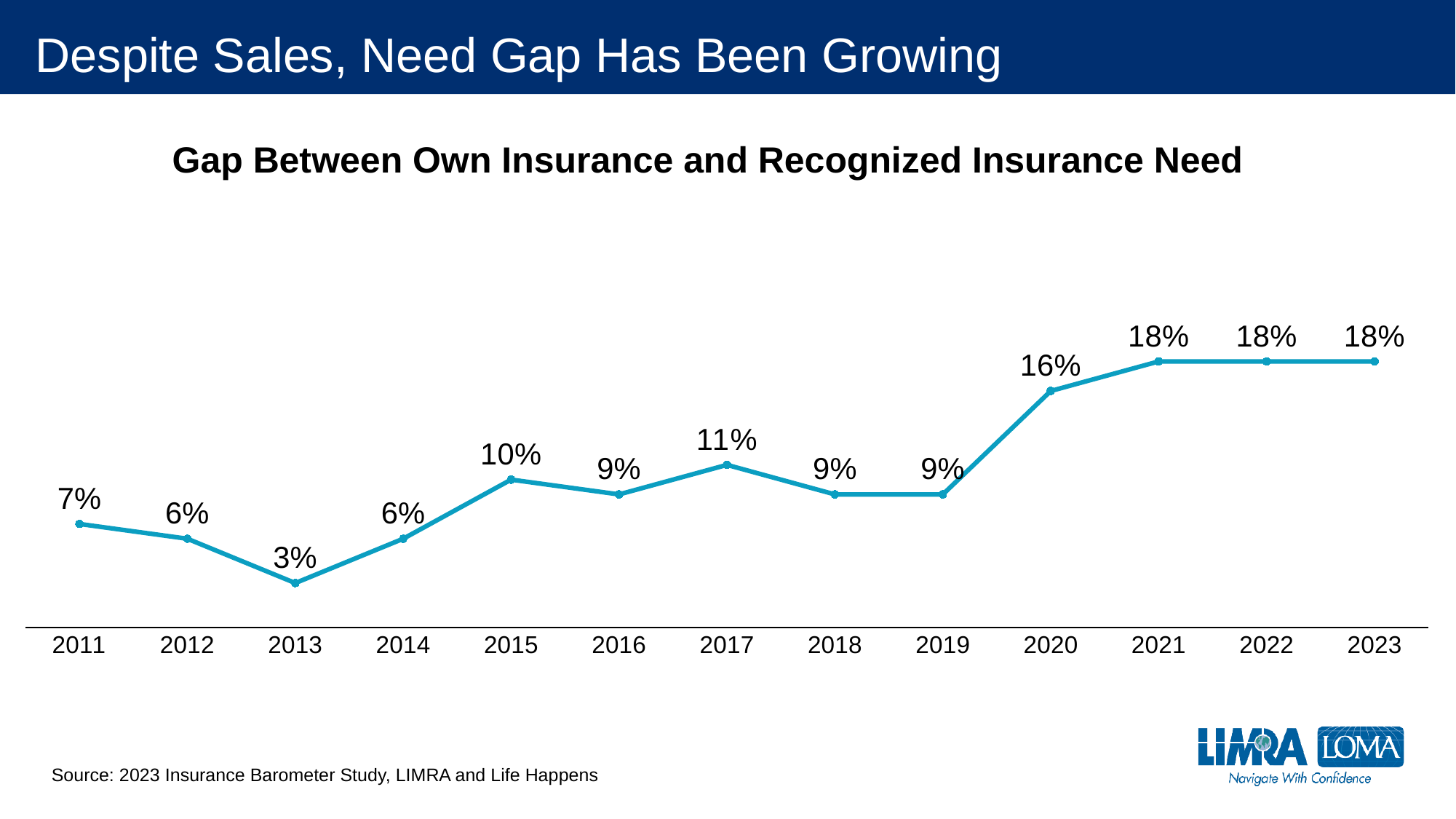
Which year has the larger gap value, 2015 or 2016? 2015 What is the difference between the gap values for 2020 and 2019? 7% How many years are plotted on the chart? 13 What is the highest gap value shown on the chart? 18% What is the gap value for 2017? 11% What is the difference between the gap values for 2023 and 2011? 11% What kind of chart is shown on the slide? Line chart What is the title of the chart? Gap Between Own Insurance and Recognized Insurance Need Which year has the lowest gap value? 2013 What is the gap value for 2013? 3% Does the gap value rise or fall from 2019 to 2021? Rise What is the gap value for 2020? 16%